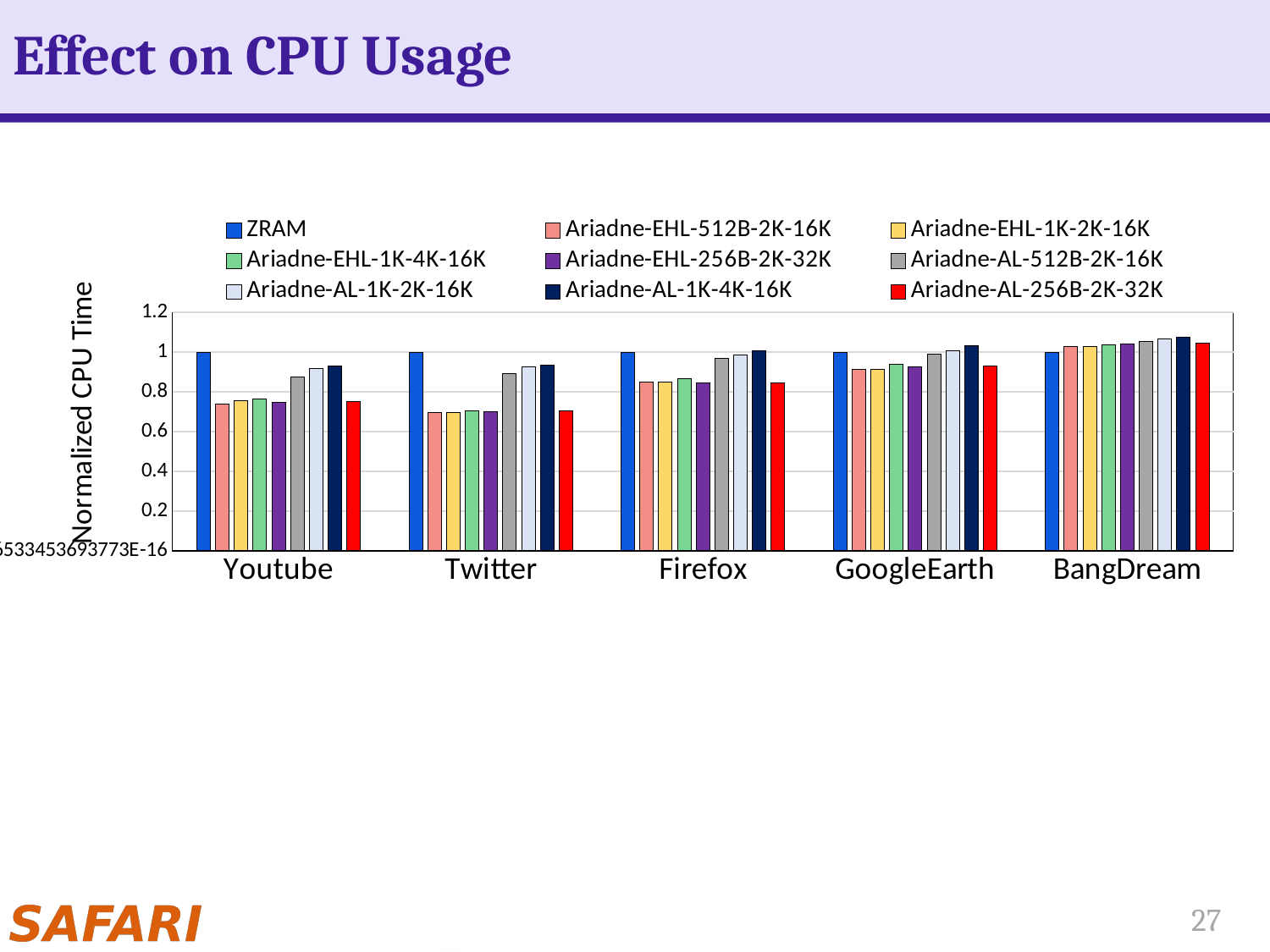
Is the value for Ariadne-EHL-1K-2K-16K on GoogleEarth greater or less than 1? less What kind of chart is shown on the slide? bar chart On Twitter, which is larger: Ariadne-AL-1K-4K-16K or Ariadne-EHL-512B-2K-16K? Ariadne-AL-1K-4K-16K Is the value for Ariadne-EHL-512B-2K-16K on Youtube greater or less than 0.8? less What is the label on the y axis? Normalized CPU Time For which application is the Ariadne-AL-256B-2K-32K value highest? BangDream Is the value for Ariadne-AL-256B-2K-32K on Twitter greater or less than 0.8? less What is the normalized CPU time for ZRAM on Youtube? 1 On Firefox, which is larger: ZRAM or Ariadne-AL-256B-2K-32K? ZRAM How many series does the legend list? 9 How many application categories are shown on the x axis? 5